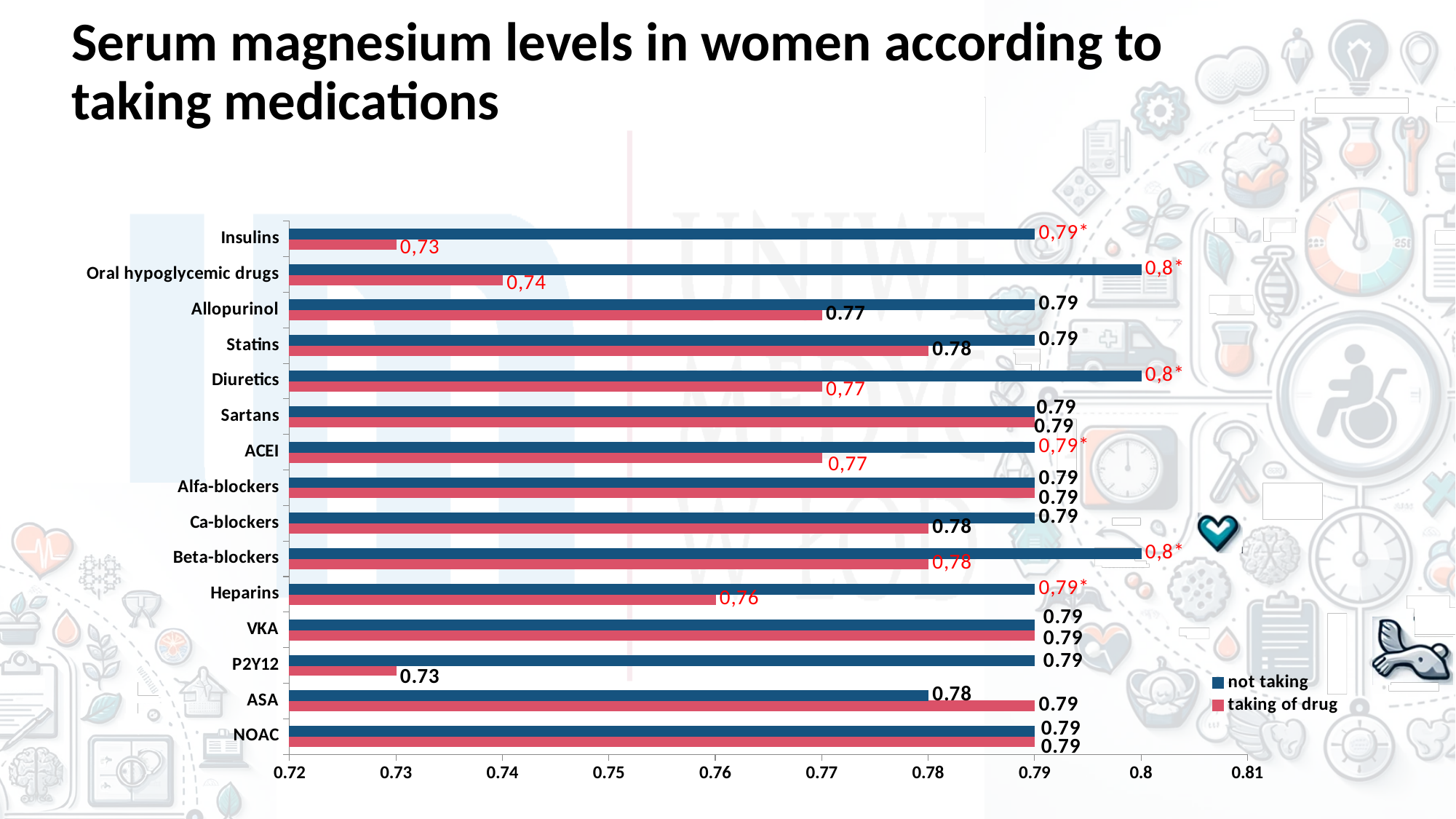
How many medication categories are shown on the chart? 15 How many series does the legend list? 2 What is the value for Heparins in the 'taking of drug' series? 0,76 What is the value for Allopurinol in the 'taking of drug' series? 0.77 What is the value for ASA in the 'not taking' series? 0.78 For ASA, which is larger: the 'not taking' value or the 'taking of drug' value? taking of drug What is the serum magnesium level for women taking P2Y12 (taking of drug)? 0.73 What are the two series names listed in the legend? not taking; taking of drug What is the difference between the 'not taking' and 'taking of drug' values for Allopurinol? 0.02 Is the 'taking of drug' value for Insulins greater or less than 0.75? less What kind of chart is shown on the slide? bar chart What is the difference between the 'not taking' and 'taking of drug' values for P2Y12? 0.06